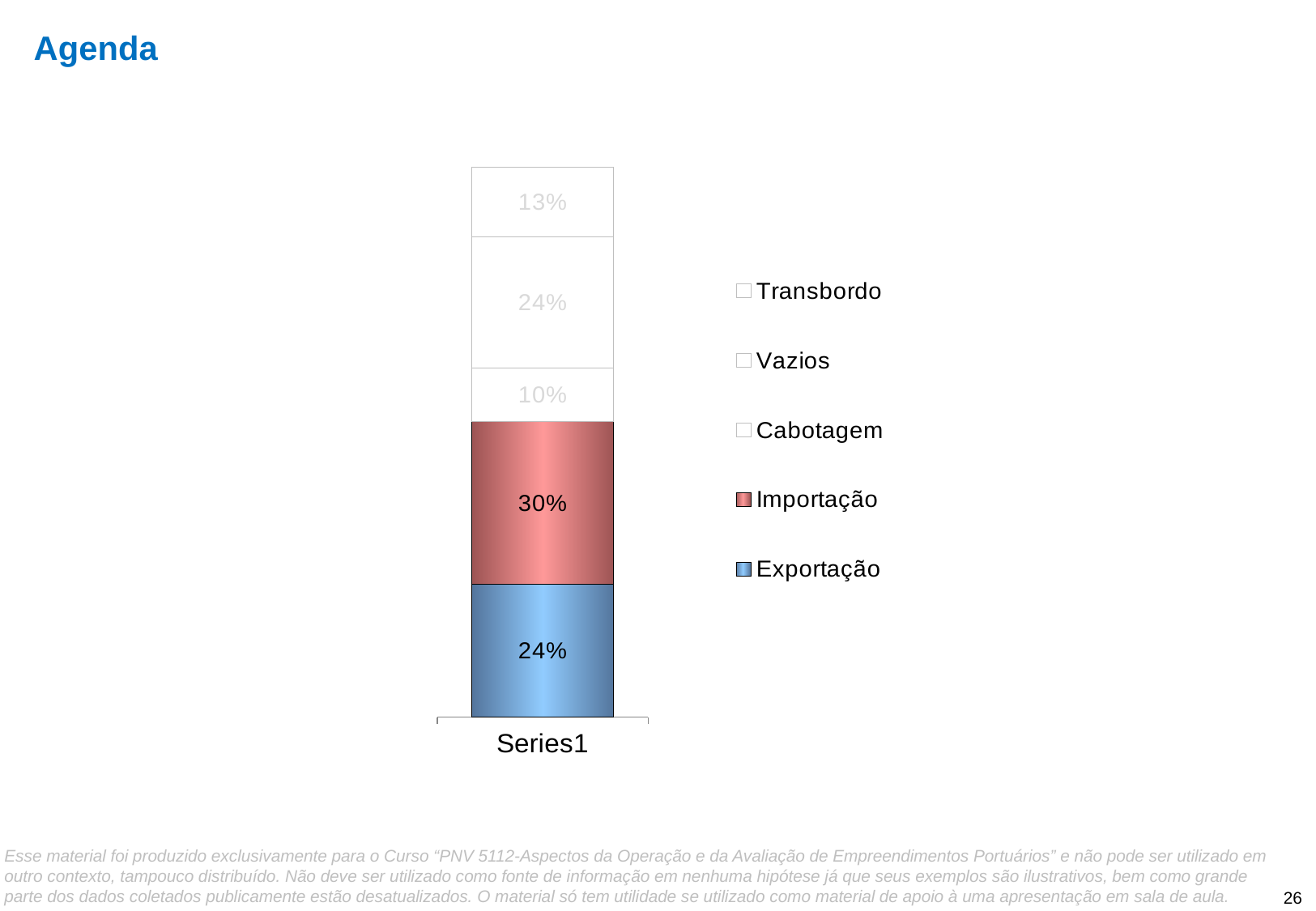
What kind of chart is shown on the slide? Stacked bar chart What percentage is shown for Cabotagem in the stacked bar? 10% Which series has the largest share in the stacked bar? Importação What percentage is shown for Exportação in the stacked bar? 24% What is the difference between the Importação and Exportação percentages? 6% Which series is at the bottom of the stacked bar? Exportação Which series has the smallest share in the stacked bar? Cabotagem What percentage is shown for Vazios in the stacked bar? 24% Which is larger, the Transbordo share or the Cabotagem share? Transbordo How many series does the legend list? 5 What percentage is shown for Transbordo in the stacked bar? 13% What percentage is shown for Importação in the stacked bar? 30%